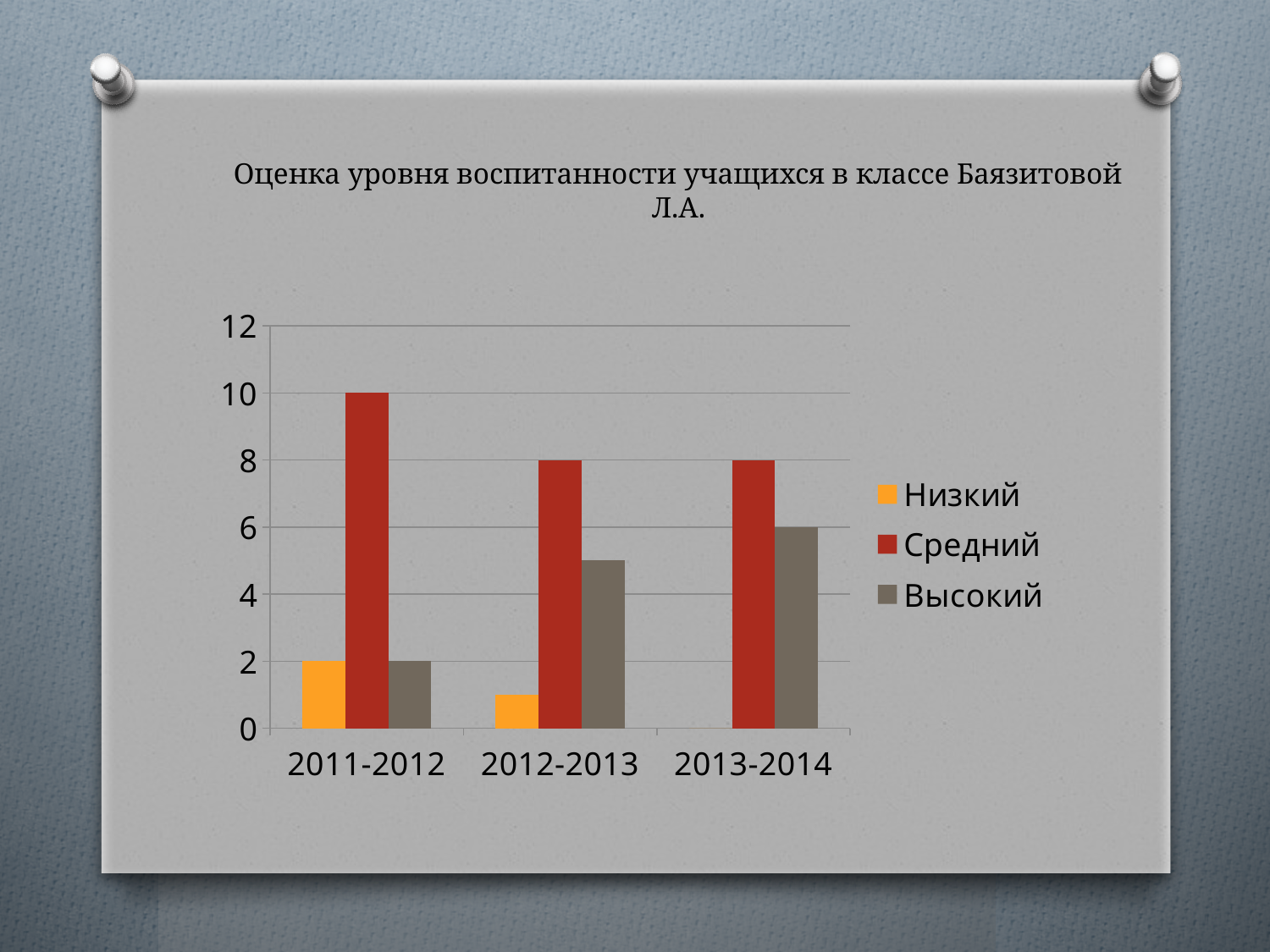
What kind of chart is shown on the slide? bar chart In which school year is the Средний value highest? 2011-2012 What is the value for Средний in 2011-2012? 10 Which is larger: the Высокий value in 2011-2012 or in 2013-2014? 2013-2014 What is the value for Низкий in 2011-2012? 2 Is the value for Высокий in 2012-2013 greater or less than 4? greater What is the difference between the Средний value in 2011-2012 and in 2012-2013? 2 Is the value for Низкий in 2012-2013 greater or less than 2? less How many school-year categories are shown on the x axis? 3 Do the Высокий values rise or fall from 2011-2012 to 2013-2014? rise What is the value for Высокий in 2013-2014? 6 How many series does the legend list? 3